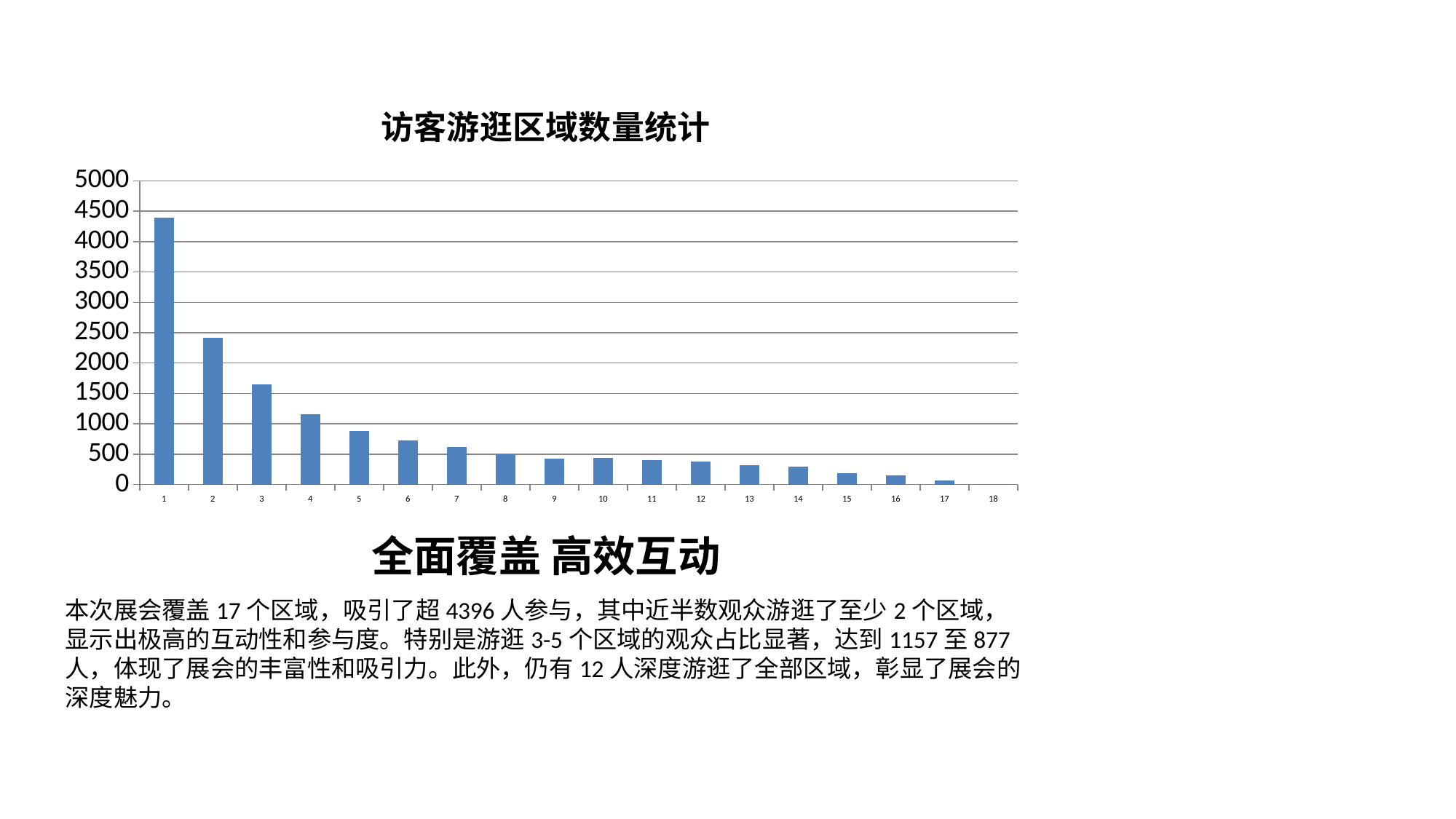
Is the value for category 2 greater or less than 2000? greater Which category has the highest bar in the chart? 1 Which is larger, the value for category 3 or the value for category 4? category 3 How many categories are shown on the x axis of the chart? 18 Is the value for category 13 greater or less than 500? less What kind of chart is shown on the slide? bar chart What is the highest value shown on the y axis of the chart? 5000 Is the value for category 1 greater or less than 4000? greater Do the values rise or fall as you move from category 1 to category 17 along the x axis? fall What is the title of the chart? 访客游逛区域数量统计